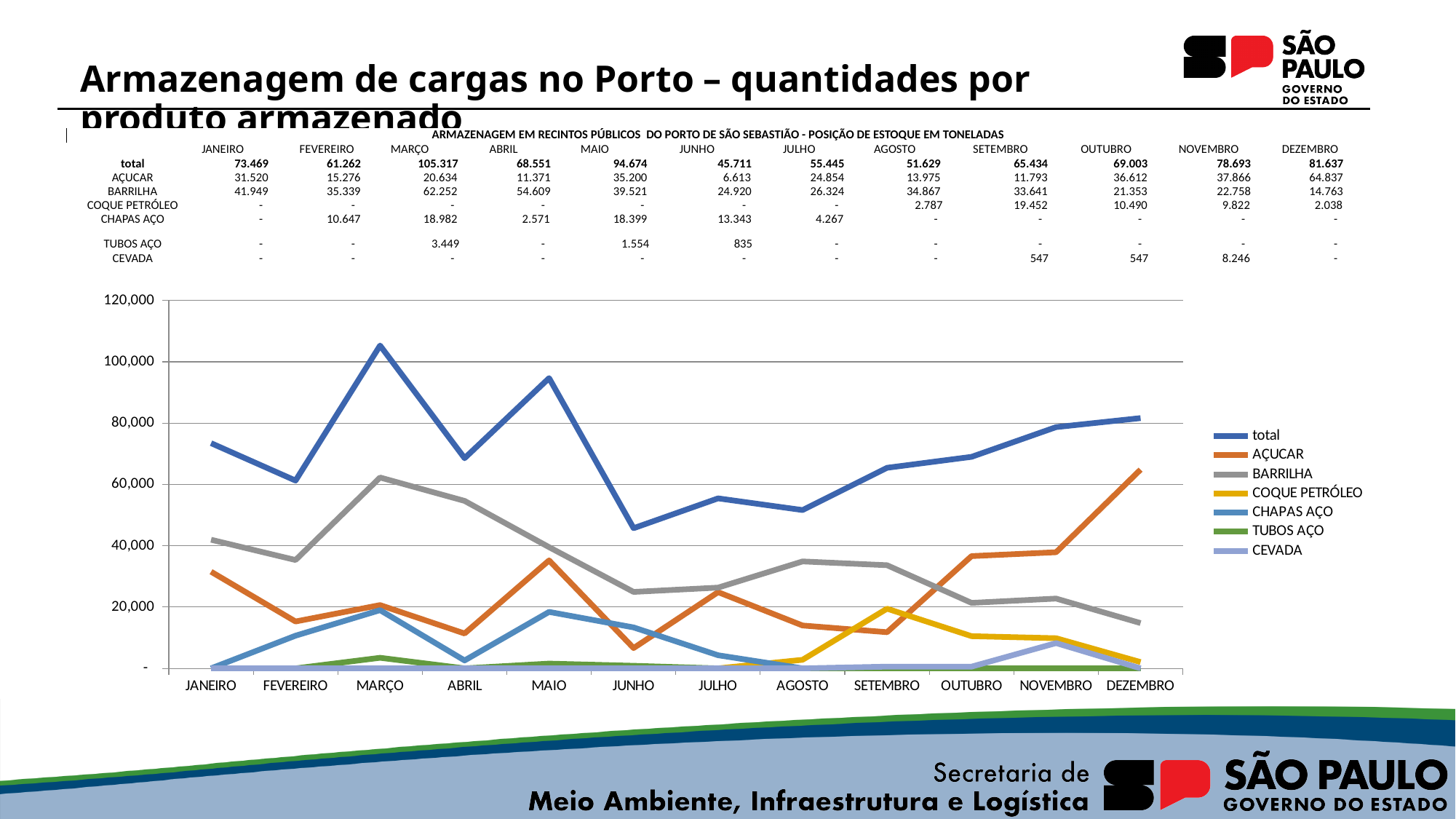
What is the difference between the total for MARÇO and the total for JUNHO? 59.606 Does the total line rise or fall from AGOSTO to DEZEMBRO? rise What is the CEVADA value for NOVEMBRO? 8.246 What is the total stock in MARÇO, as printed in the table? 105.317 Is the total value for MARÇO greater or less than 100,000? greater How many months are plotted along the x axis of the chart? 12 In which month is the total stock lowest? JUNHO What kind of chart is shown on the slide? line chart What is the AÇUCAR value for DEZEMBRO? 64.837 How many series does the chart legend list? 7 In which month is the total stock highest? MARÇO In JANEIRO, which is larger: AÇUCAR or BARRILHA? BARRILHA